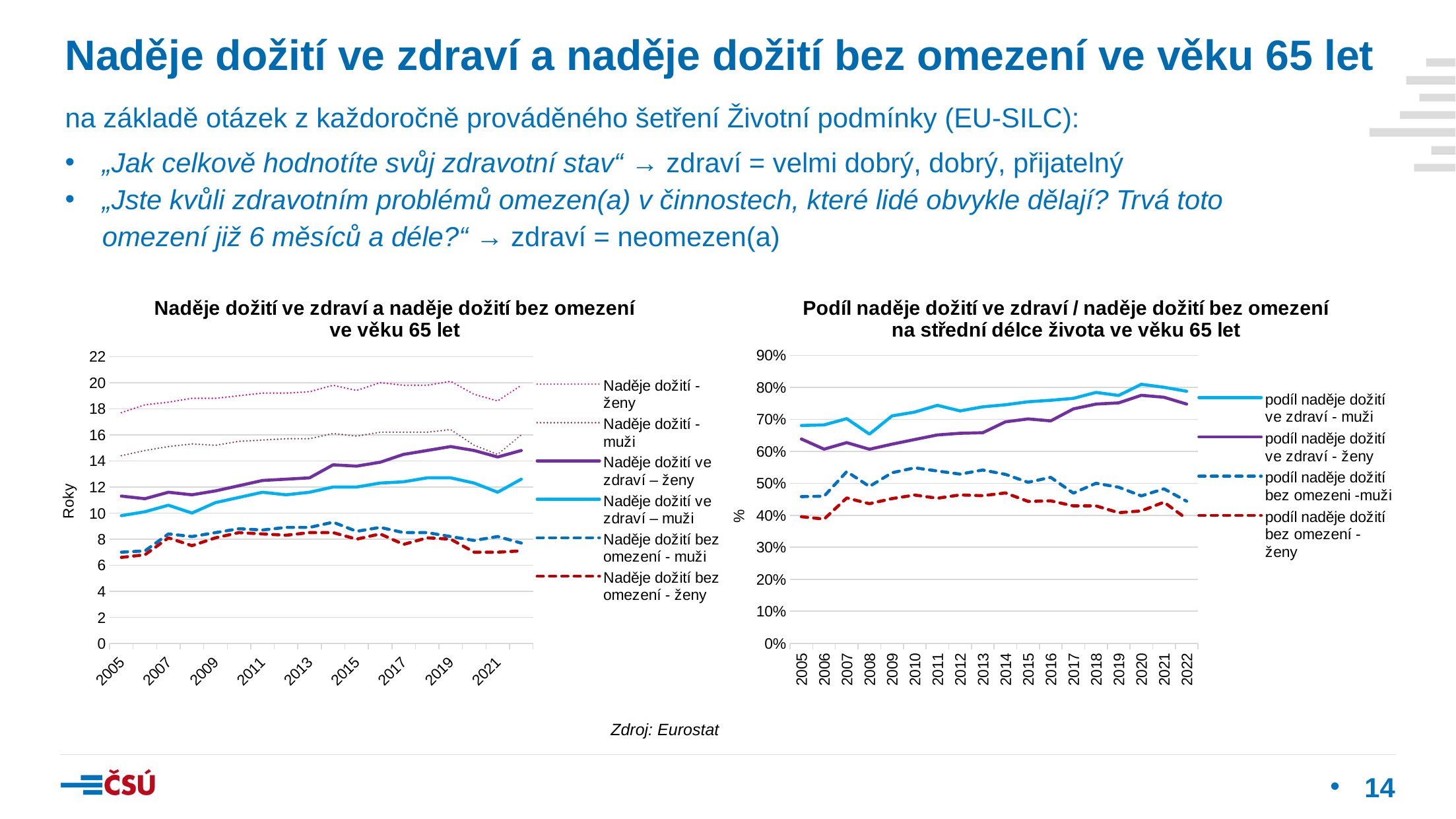
How many series does the legend of the right chart list? 4 In the right chart, is the value for "podíl naděje dožití ve zdraví - muži" in 2020 greater or less than 70%? greater What kind of chart is the left chart titled "Naděje dožití ve zdraví a naděje dožití bez omezení ve věku 65 let"? line chart In the left chart, which is higher in 2022: "Naděje dožití ve zdraví – ženy" or "Naděje dožití ve zdraví – muži"? Naděje dožití ve zdraví – ženy In the left chart, what is the label of the y axis? Roky What kind of chart is the right chart titled "Podíl naděje dožití ve zdraví / naděje dožití bez omezení na střední délce života ve věku 65 let"? line chart In the right chart, is the value for "podíl naděje dožití bez omezení - ženy" in 2005 greater or less than 50%? less In the right chart, what is the first year shown on the x axis? 2005 In the left chart, is the value for "Naděje dožití - ženy" in 2005 greater or less than 16? greater In the right chart, how many years are shown on the x axis? 18 How many series does the legend of the left chart list? 6